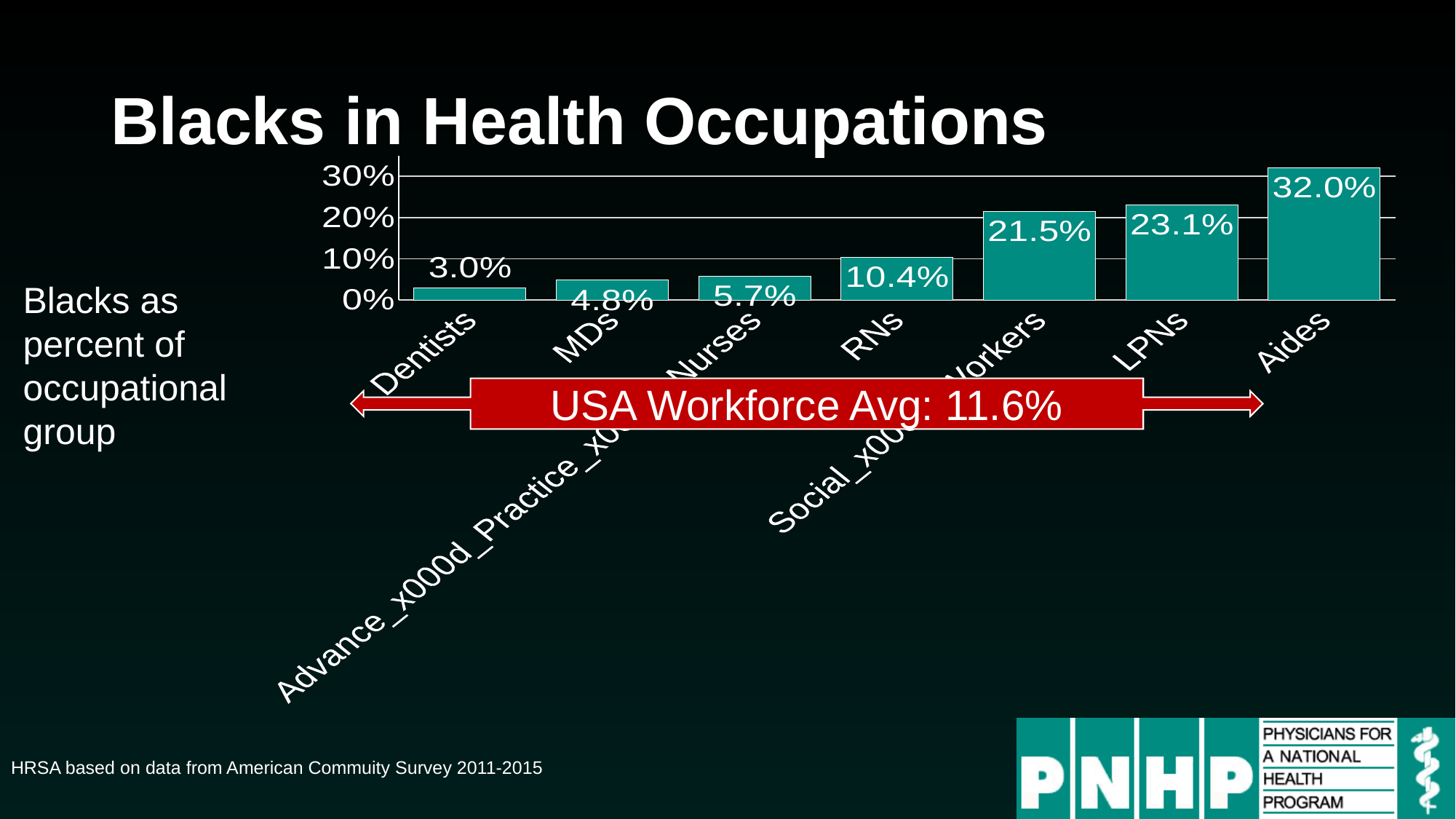
What is the value for MDs? 4.8% What is the value for RNs? 10.4% What is the value for Dentists? 3.0% How many occupational groups are shown in the chart? 7 What is the difference between the values for Aides and LPNs? 8.9% What USA workforce average is shown on the red banner across the chart? 11.6% What is the value for Aides? 32.0% Which occupational group has the highest value? Aides What kind of chart is shown on the slide? Bar chart Which is larger, the value for MDs or the value for RNs? RNs What is the value for LPNs? 23.1% Which occupational group has the lowest value? Dentists